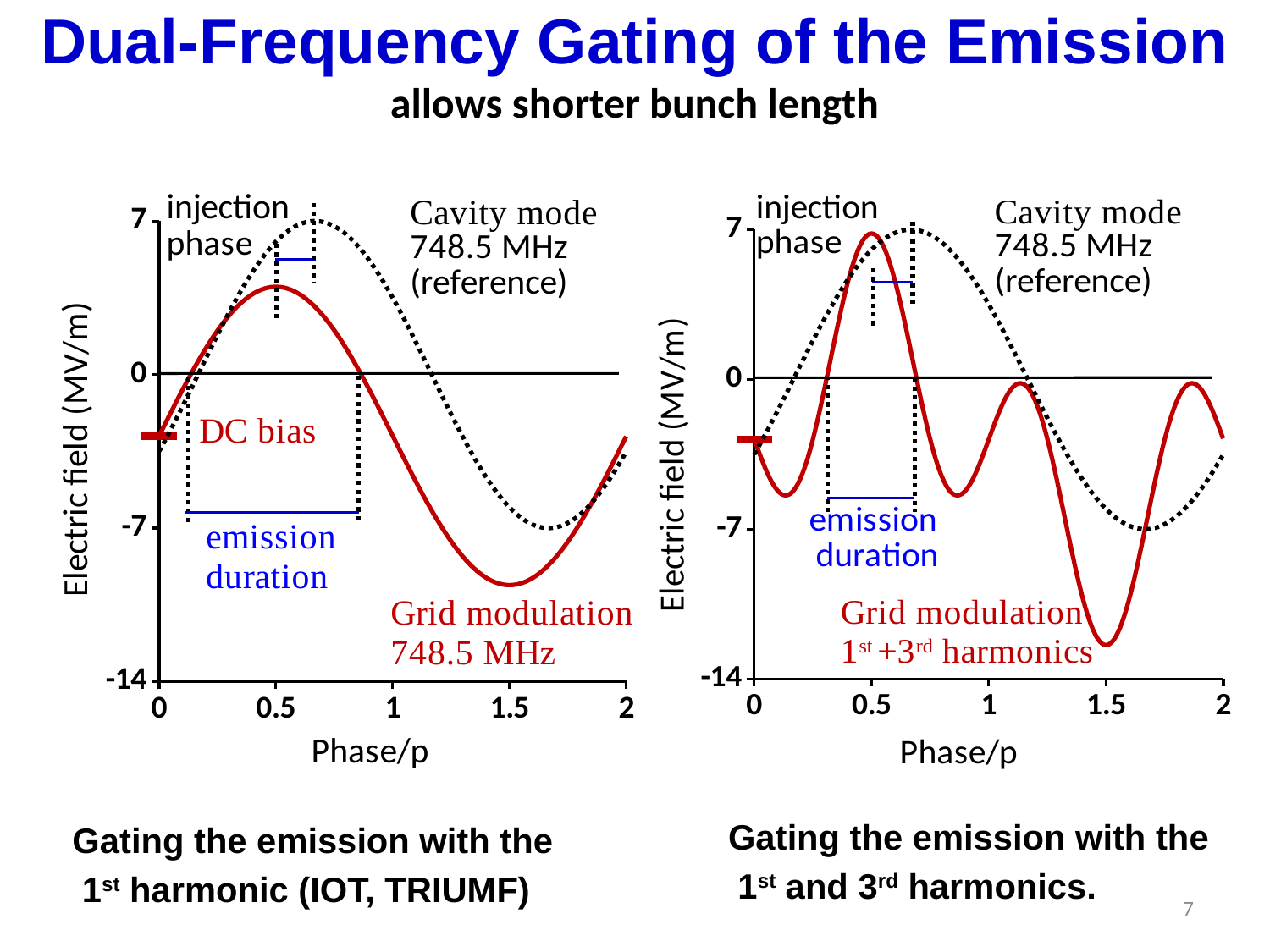
In the right chart, what is the label of the x axis? Phase/p In the left chart, is the value of the Grid modulation curve at phase 1 greater or less than -7? greater In the left chart, does the Grid modulation curve rise or fall between phase 0.5 and phase 1.5? fall In the left chart, which curve reaches the lower minimum, the Cavity mode curve or the Grid modulation curve? Grid modulation How many curves are plotted in the left chart? 2 In the left chart, is the value of the Grid modulation curve at phase 0.5 greater or less than 7? less What kind of chart is shown on the left of the slide? line chart In the left chart, is the value of the Grid modulation curve at phase 1.5 greater or less than -7? less What is the lowest tick value shown on the y axis of the right chart? -14 In the left chart, what is the label of the y axis? Electric field (MV/m) How many tick labels are shown on the x axis of the right chart? 5